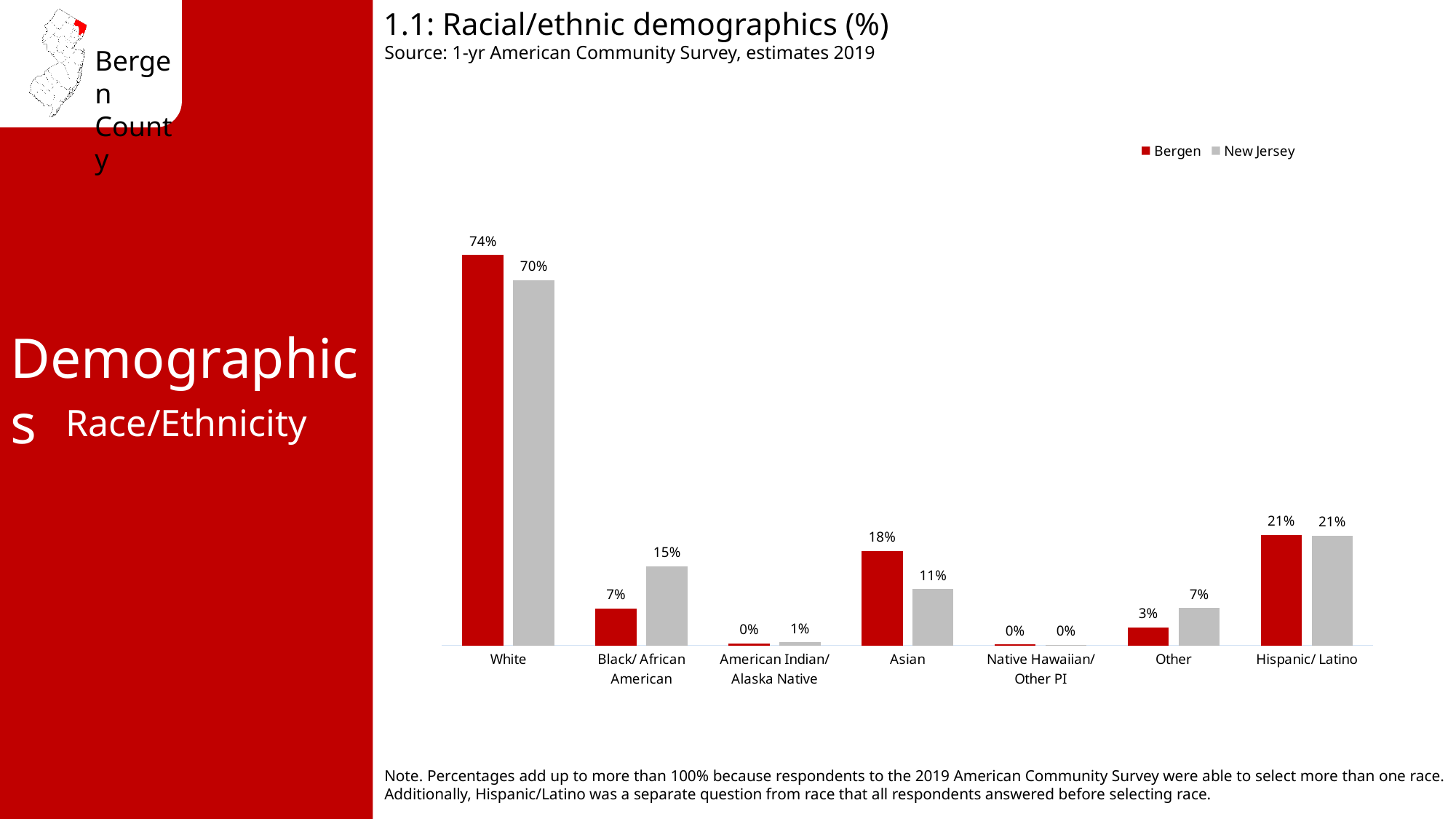
What is the New Jersey value for Other? 7% What is the New Jersey value for Black/ African American? 15% What is the Bergen value for Asian? 18% What is the difference between the New Jersey and Bergen values for Black/ African American? 8% What is the Bergen value for White? 74% Which category has the lowest New Jersey value? Native Hawaiian/ Other PI What kind of chart is shown? Bar chart Which is larger for Asian, the Bergen value or the New Jersey value? Bergen How many series does the legend list? 2 How many categories are shown on the x axis? 7 What is the difference between the Bergen and New Jersey values for White? 4% Which category has the highest Bergen value? White